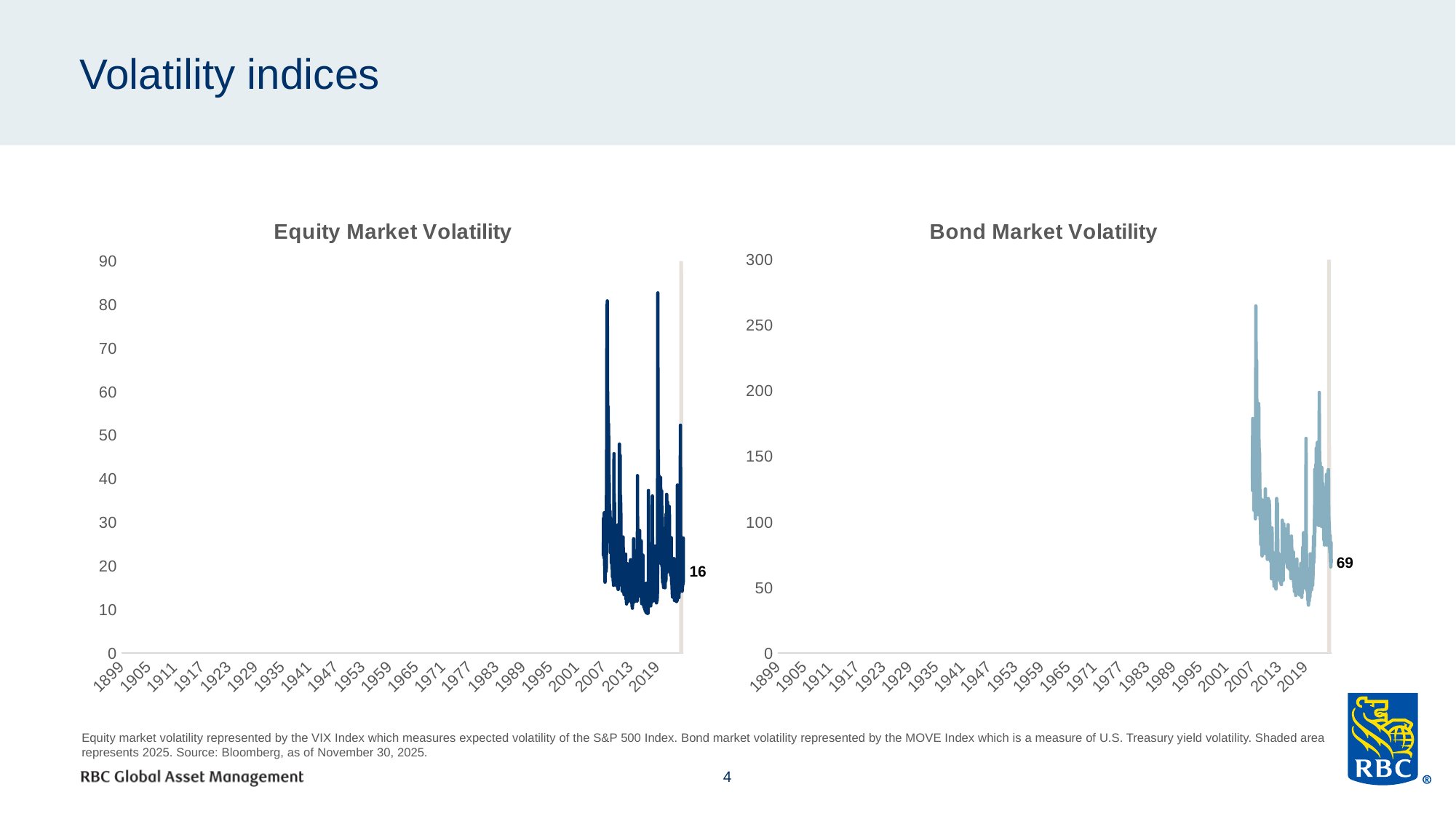
What is the difference between the labelled end value on the Bond Market Volatility chart and the labelled end value on the Equity Market Volatility chart? 53 Comparing the labelled end values, which chart shows the larger value: Equity Market Volatility or Bond Market Volatility? Bond Market Volatility On the Equity Market Volatility chart, what is the value printed at the end of the line? 16 What kind of chart is the Equity Market Volatility chart? line chart What kind of chart is the Bond Market Volatility chart? line chart On the Equity Market Volatility chart, is the highest peak of the line greater or less than 70? greater What is the highest value shown on the y axis of the Bond Market Volatility chart? 300 On the Bond Market Volatility chart, is the lowest point of the line greater or less than 50? less What is the first year label on the x axis of the Equity Market Volatility chart? 1899 On the Bond Market Volatility chart, what is the value printed at the end of the line? 69 On the Bond Market Volatility chart, is the highest peak of the line greater or less than 200? greater